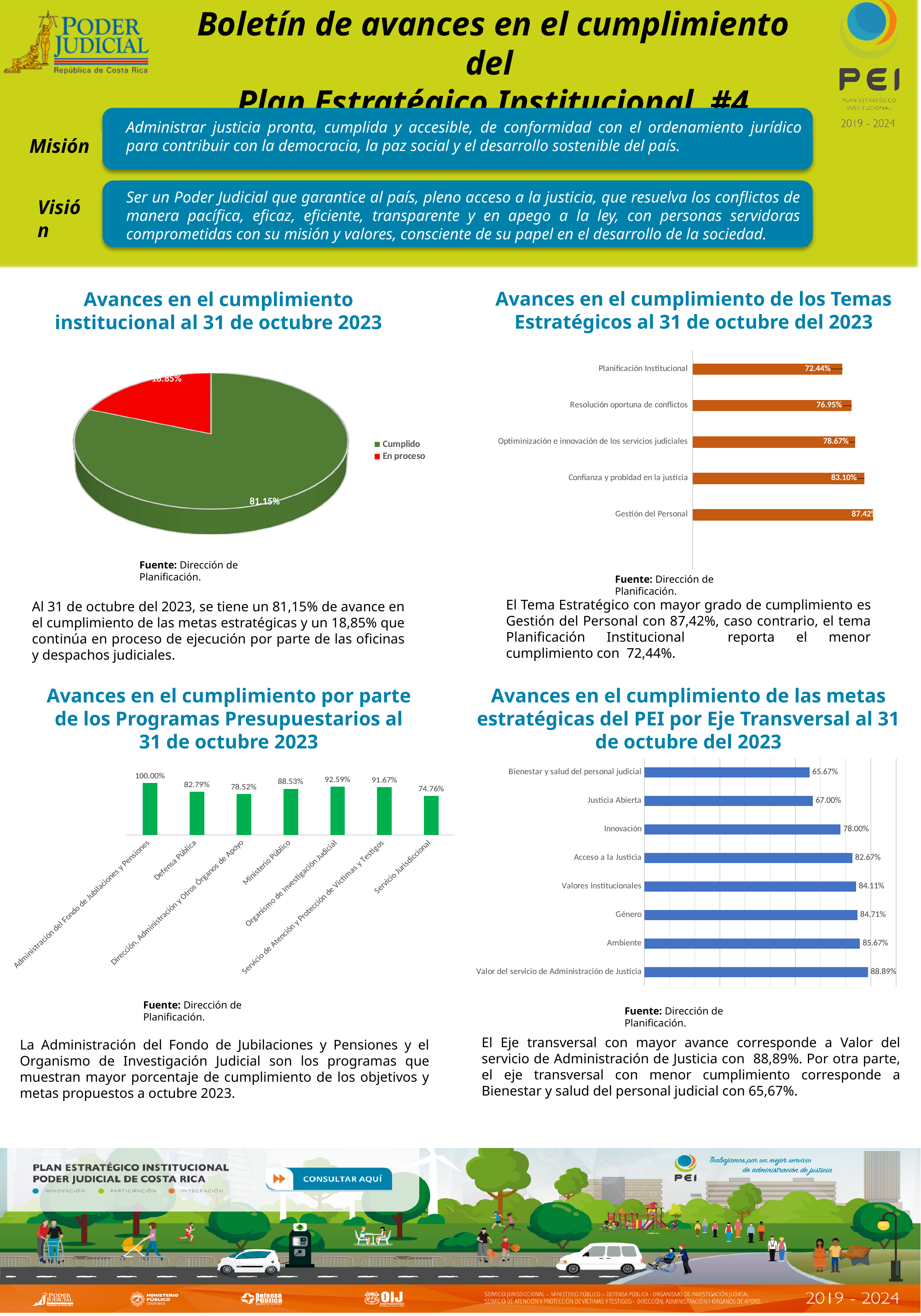
In the chart 'Avances en el cumplimiento de las metas estratégicas del PEI por Eje Transversal al 31 de octubre del 2023', which is larger, 'Justicia Abierta' or 'Acceso a la Justicia'? Acceso a la Justicia In the chart 'Avances en el cumplimiento por parte de los Programas Presupuestarios al 31 de octubre 2023', what is the value for 'Ministerio Público'? 88.53% In the chart 'Avances en el cumplimiento de los Temas Estratégicos al 31 de octubre del 2023', how many categories are shown? 5 In the chart 'Avances en el cumplimiento por parte de los Programas Presupuestarios al 31 de octubre 2023', how many categories are shown? 7 In the chart 'Avances en el cumplimiento por parte de los Programas Presupuestarios al 31 de octubre 2023', what is the difference between 'Organismo de Investigación Judicial' and 'Servicio Jurisdiccional'? 17.83% In the chart 'Avances en el cumplimiento de los Temas Estratégicos al 31 de octubre del 2023', which category has the lowest value? Planificación Institucional In the chart 'Avances en el cumplimiento de las metas estratégicas del PEI por Eje Transversal al 31 de octubre del 2023', which category has the highest value? Valor del servicio de Administración de Justicia In the chart 'Avances en el cumplimiento de las metas estratégicas del PEI por Eje Transversal al 31 de octubre del 2023', what is the value for 'Innovación'? 78.00% In the chart 'Avances en el cumplimiento por parte de los Programas Presupuestarios al 31 de octubre 2023', which category has the highest value? Administración del Fondo de Jubilaciones y Pensiones In the chart 'Avances en el cumplimiento institucional al 31 de octubre 2023', what share of the pie is 'Cumplido'? 81.15% What kind of chart is 'Avances en el cumplimiento institucional al 31 de octubre 2023'? Pie chart In the chart 'Avances en el cumplimiento de los Temas Estratégicos al 31 de octubre del 2023', what is the value for 'Confianza y probidad en la justicia'? 83.10%